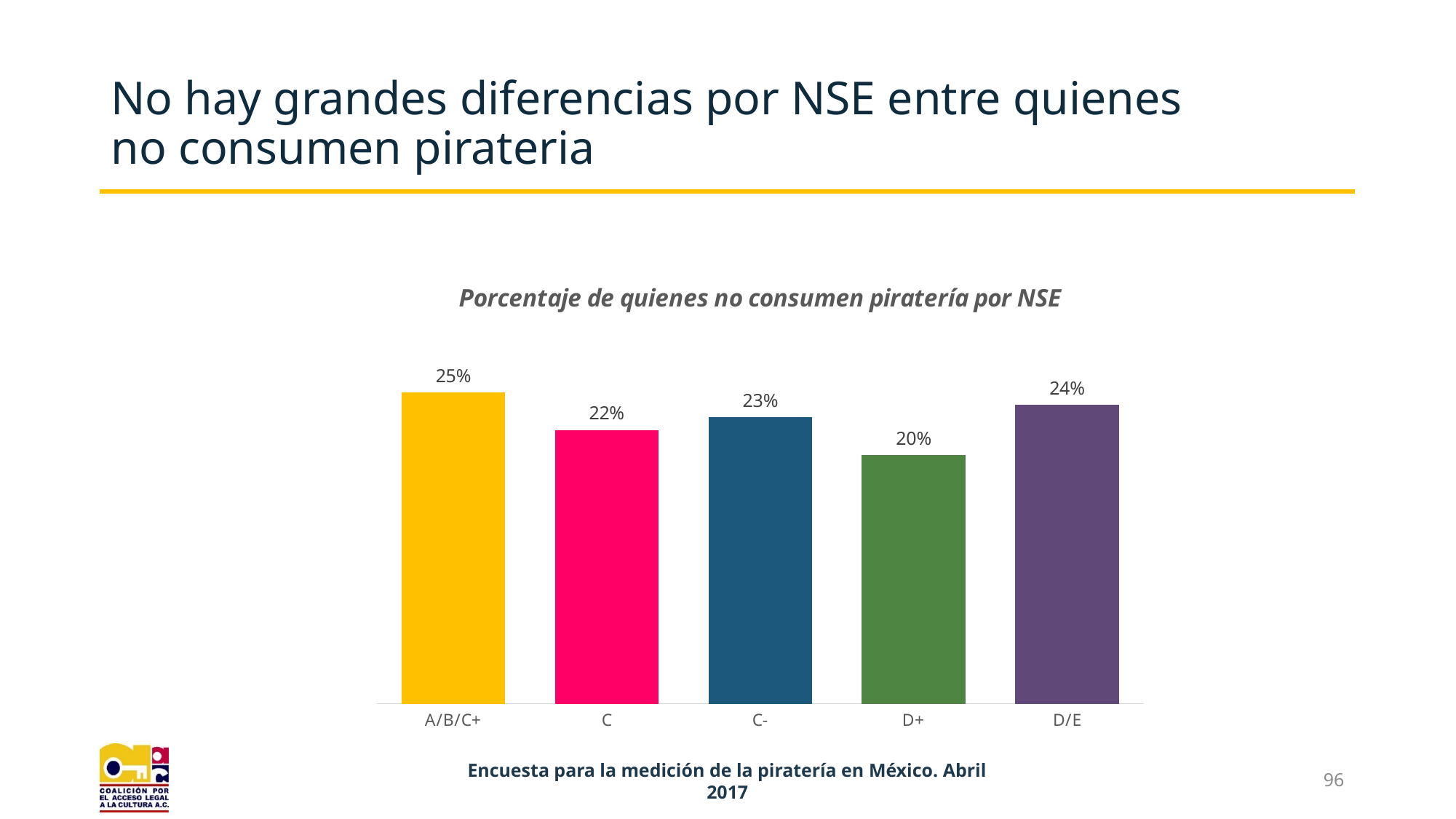
Which is larger, the value for C or the value for D/E? D/E What is the title of the chart? Porcentaje de quienes no consumen piratería por NSE Which category has the lowest value? D+ What is the value for C? 22% What is the difference between the values for A/B/C+ and D+? 5% Which category has the highest value? A/B/C+ What kind of chart is shown on the slide? Bar chart What is the value for D+? 20% What is the value for C-? 23% How many categories are shown on the x axis? 5 What is the value for D/E? 24% What is the value for A/B/C+? 25%